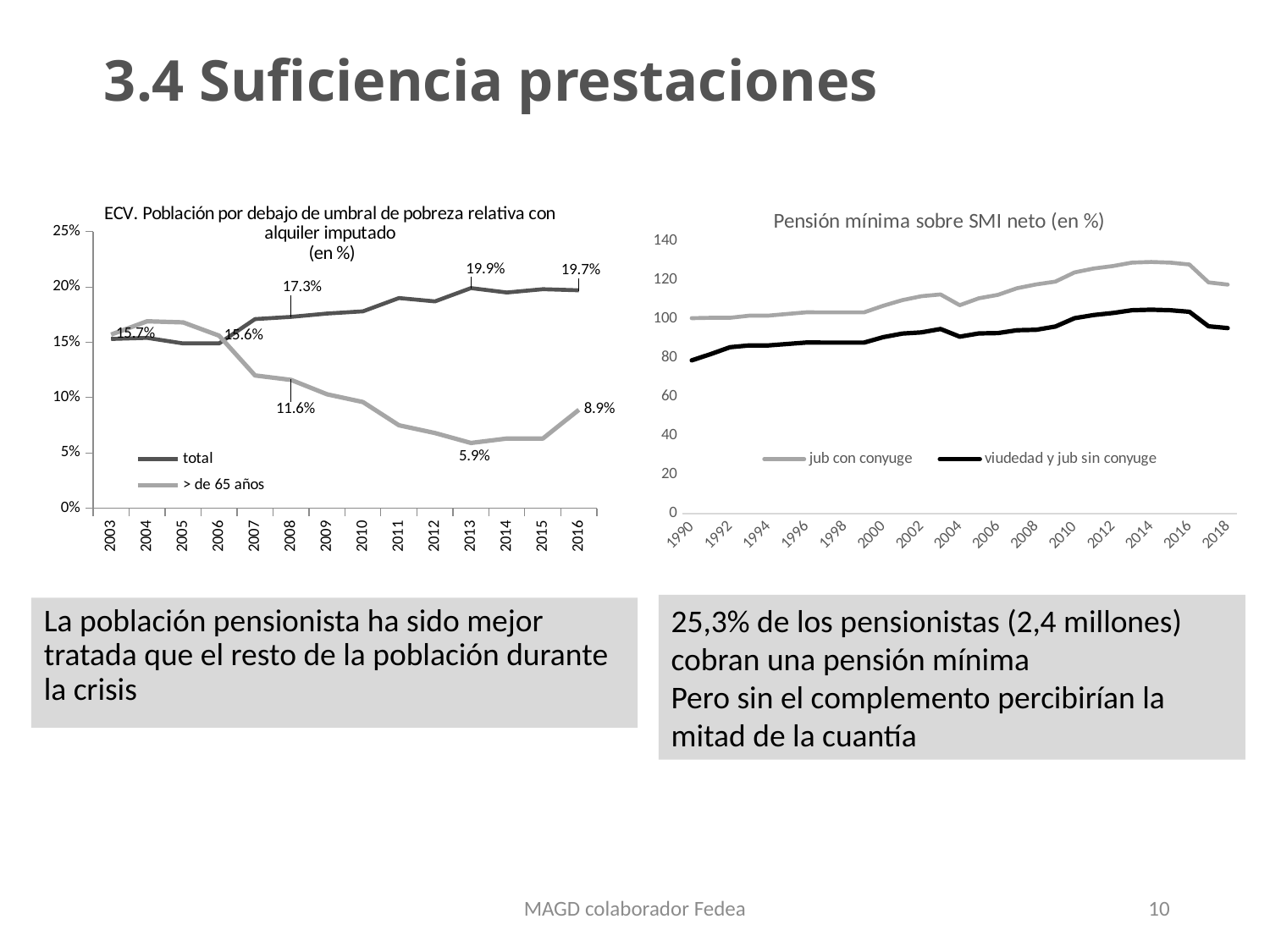
In the left chart (ECV. Población por debajo de umbral de pobreza relativa), what is the value of the '> de 65 años' series in 2008? 11.6% In the right chart (Pensión mínima sobre SMI neto), which series has the higher value in 2014, 'jub con conyuge' or 'viudedad y jub sin conyuge'? jub con conyuge In the left chart (ECV. Población por debajo de umbral de pobreza relativa), what is the value of the 'total' series in 2013? 19.9% What kind of chart is the right chart (Pensión mínima sobre SMI neto)? line chart In the left chart (ECV. Población por debajo de umbral de pobreza relativa), which series has the higher value in 2013, 'total' or '> de 65 años'? total In the right chart (Pensión mínima sobre SMI neto), how many series does the legend list? 2 In the left chart (ECV. Población por debajo de umbral de pobreza relativa), what is the value of the '> de 65 años' series in 2016? 8.9% In the left chart (ECV. Población por debajo de umbral de pobreza relativa), how many years are shown on the x axis? 14 In the left chart (ECV. Población por debajo de umbral de pobreza relativa), what is the difference between the 'total' and '> de 65 años' values in 2016? 10.8 percentage points In the right chart (Pensión mínima sobre SMI neto), is the value for 'jub con conyuge' in 2014 greater or less than 120? greater